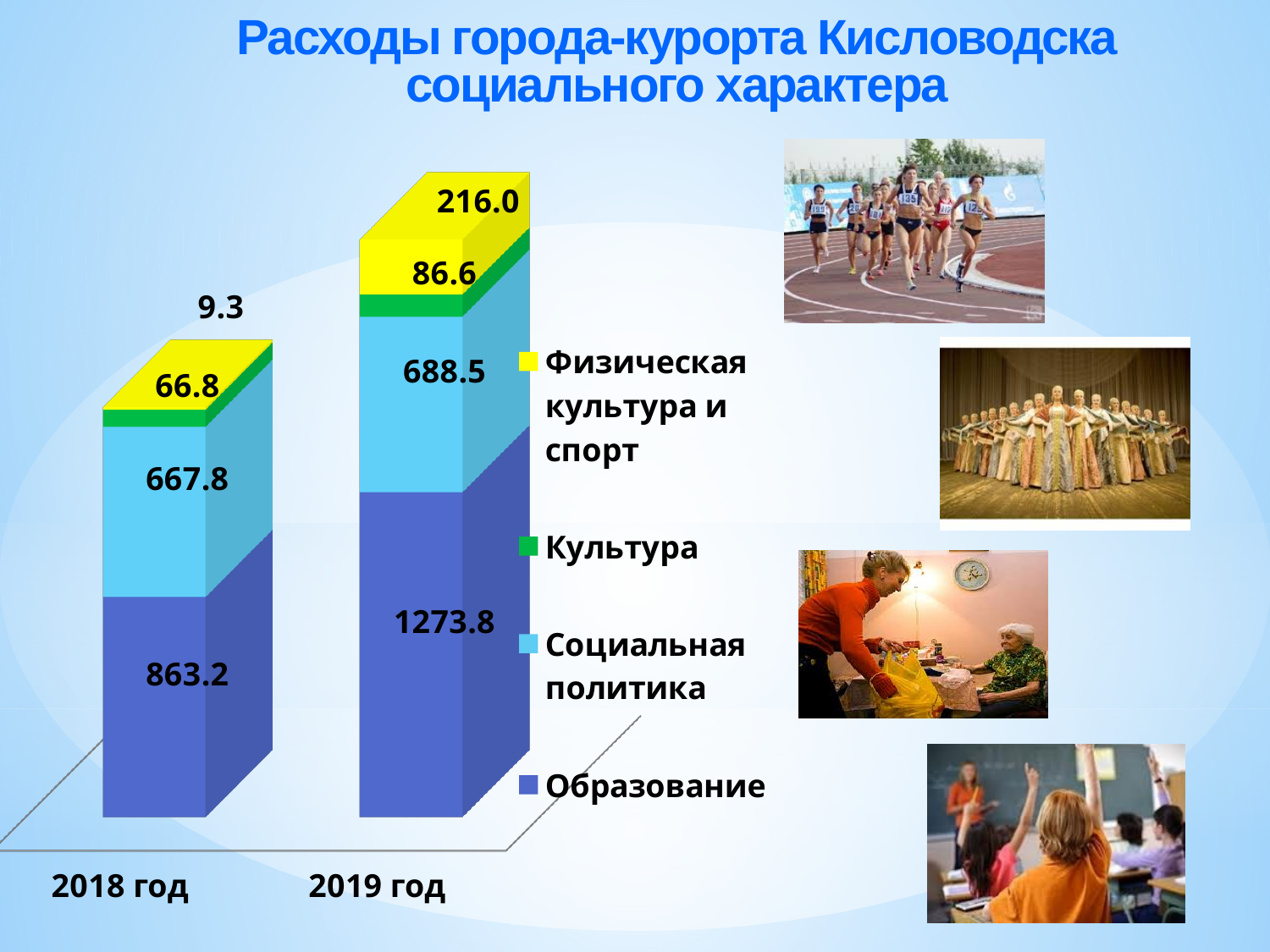
Which series has the largest value in the 2018 год bar? Образование What is the difference between the Образование values for 2019 год and 2018 год? 410.6 What is the value for Культура in 2018 год? 66.8 What kind of chart is shown on the slide? Stacked bar chart What is the value for Физическая культура и спорт in 2019 год? 216.0 Which year has the larger value for Культура, 2018 год or 2019 год? 2019 год How many series does the legend list? 4 What is the total of the stacked bar for 2018 год? 1607.1 Which series has the smallest value in the 2018 год bar? Физическая культура и спорт What is the difference between the Физическая культура и спорт values for 2019 год and 2018 год? 206.7 What is the value for Социальная политика in 2018 год? 667.8 What is the value for Образование in 2019 год? 1273.8